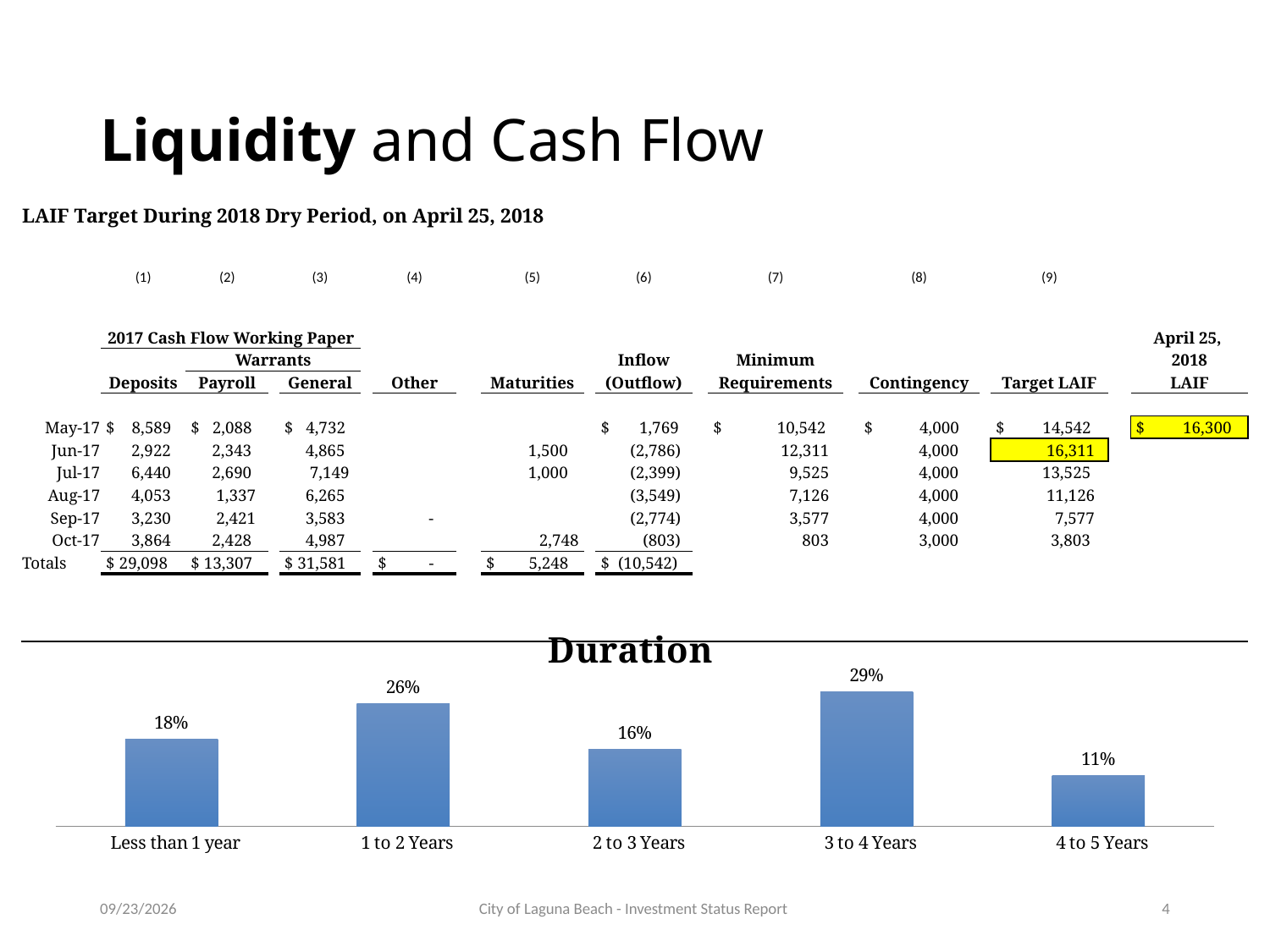
What is the title of the chart at the bottom of the slide? Duration In the Duration chart, what is the difference between the values for '1 to 2 Years' and '2 to 3 Years'? 10% In the Duration chart, what is the value for '4 to 5 Years'? 11% In the Duration chart, what is the value for 'Less than 1 year'? 18% In the Duration chart, what is the difference between the values for '3 to 4 Years' and '4 to 5 Years'? 18% In the Duration chart, which category has the highest value? 3 to 4 Years In the Duration chart, which category has the lowest value? 4 to 5 Years What kind of chart is the Duration chart? Bar chart In the Duration chart, which is larger: the value for 'Less than 1 year' or the value for '2 to 3 Years'? Less than 1 year How many categories are shown in the Duration chart? 5 In the Duration chart, what is the value for '1 to 2 Years'? 26% In the Duration chart, what is the value for '2 to 3 Years'? 16%